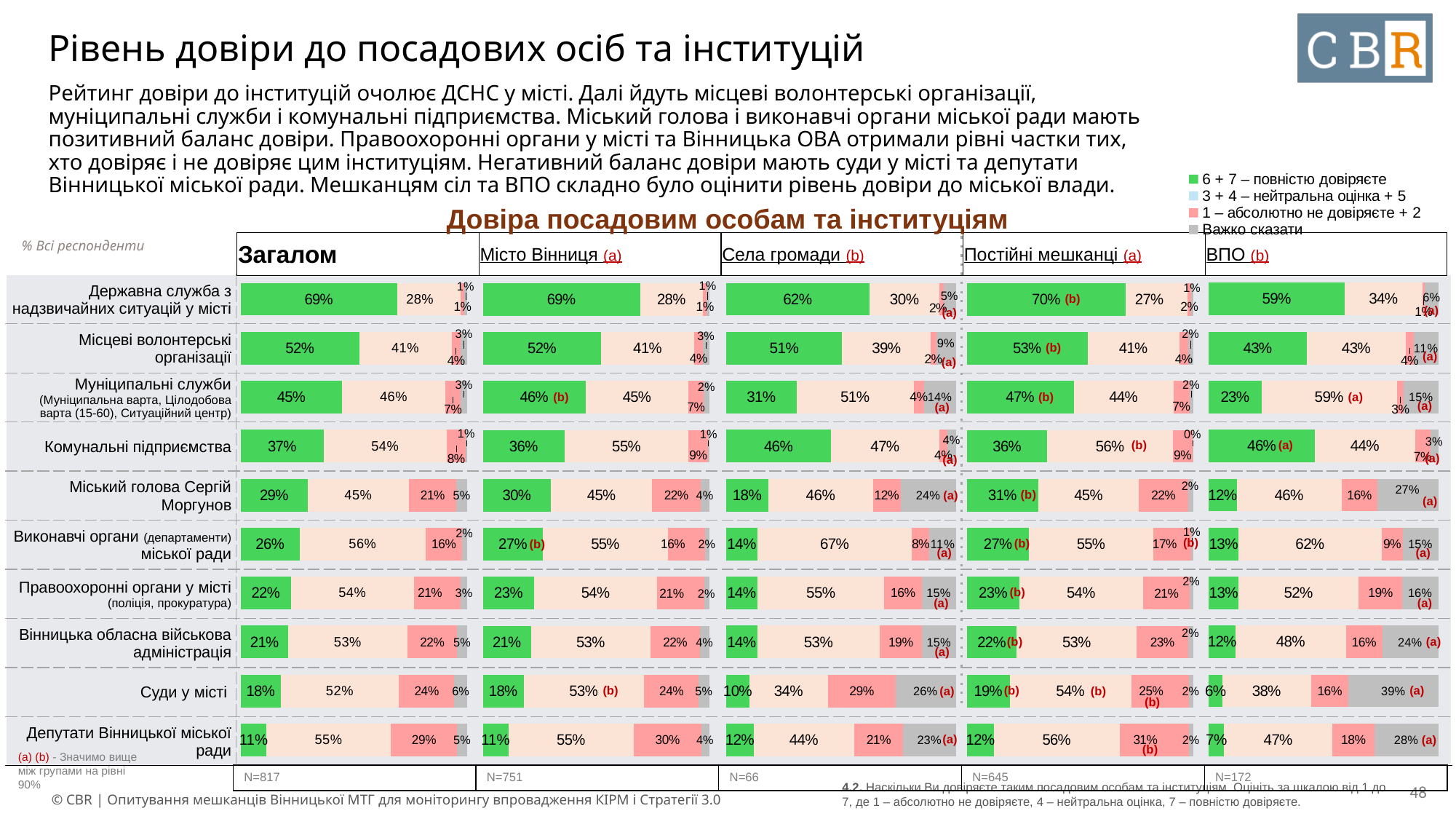
In the Місто Вінниця panel, what share gave 1 – абсолютно не довіряєте + 2 for Суди у місті? 24% How many institutions (row categories) are shown in the chart? 10 In the Загалом panel, what share of respondents fully trust (6 + 7 – повністю довіряєте) the Державна служба з надзвичайних ситуацій у місті? 69% In the Села громади panel, which has the larger full-trust share: Комунальні підприємства or Муніципальні служби? Комунальні підприємства In the Постійні мешканці panel, what share fully trust Міський голова Сергій Моргунов? 31% How many series does the legend list? 4 What kind of chart is used on this slide? Stacked bar chart In the Загалом panel, which institution has the highest share of 6 + 7 – повністю довіряєте? Державна служба з надзвичайних ситуацій у місті In the Загалом panel, what is the difference in percentage points between the full-trust share for Державна служба з надзвичайних ситуацій у місті (69%) and for Депутати Вінницької міської ради (11%)? 58 percentage points What is the title of the chart? Довіра посадовим особам та інституціям In the Загалом panel, which institution has the lowest share of 6 + 7 – повністю довіряєте? Депутати Вінницької міської ради In the ВПО panel, what share answered Важко сказати for Суди у місті? 39%